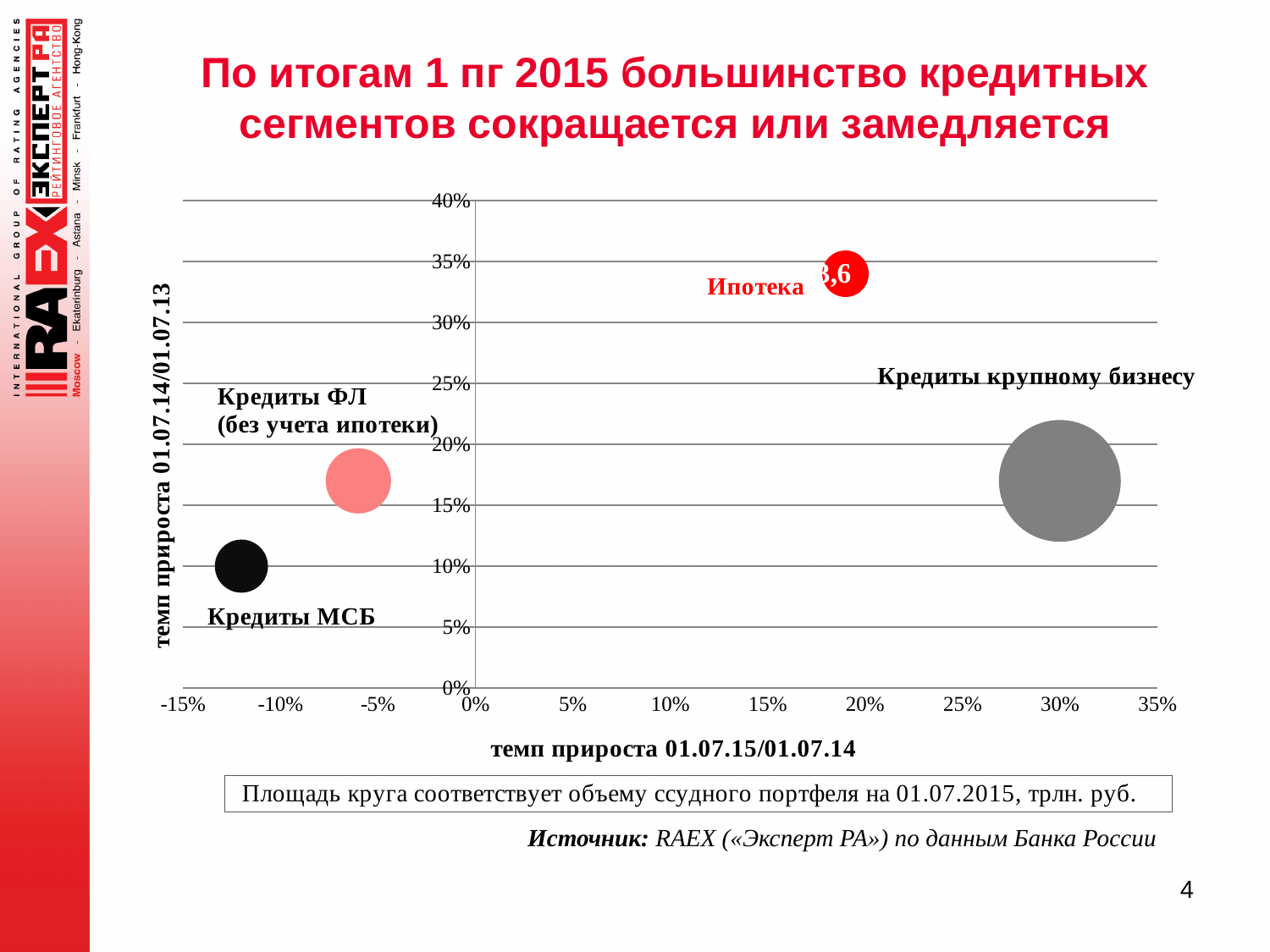
What kind of chart is shown on the slide? Bubble chart What is the title of the horizontal axis? темп прироста 01.07.15/01.07.14 Which segment has the lowest growth rate on the horizontal axis (темп прироста 01.07.15/01.07.14)? Кредиты МСБ Which segment has the lowest growth rate on the vertical axis (темп прироста 01.07.14/01.07.13)? Кредиты МСБ Is the vertical-axis value for Ипотека greater or less than 30%? greater How many credit segments (bubbles) are plotted on the chart? 4 Which has the higher vertical-axis value: Ипотека or Кредиты ФЛ (без учета ипотеки)? Ипотека Which segment is represented by the largest bubble? Кредиты крупному бизнесу Which segment has the highest growth rate on the vertical axis (темп прироста 01.07.14/01.07.13)? Ипотека Is the horizontal-axis value for Кредиты крупному бизнесу greater or less than 25%? greater Is the horizontal-axis value for Кредиты МСБ greater or less than -10%? less Which segment has the highest growth rate on the horizontal axis (темп прироста 01.07.15/01.07.14)? Кредиты крупному бизнесу